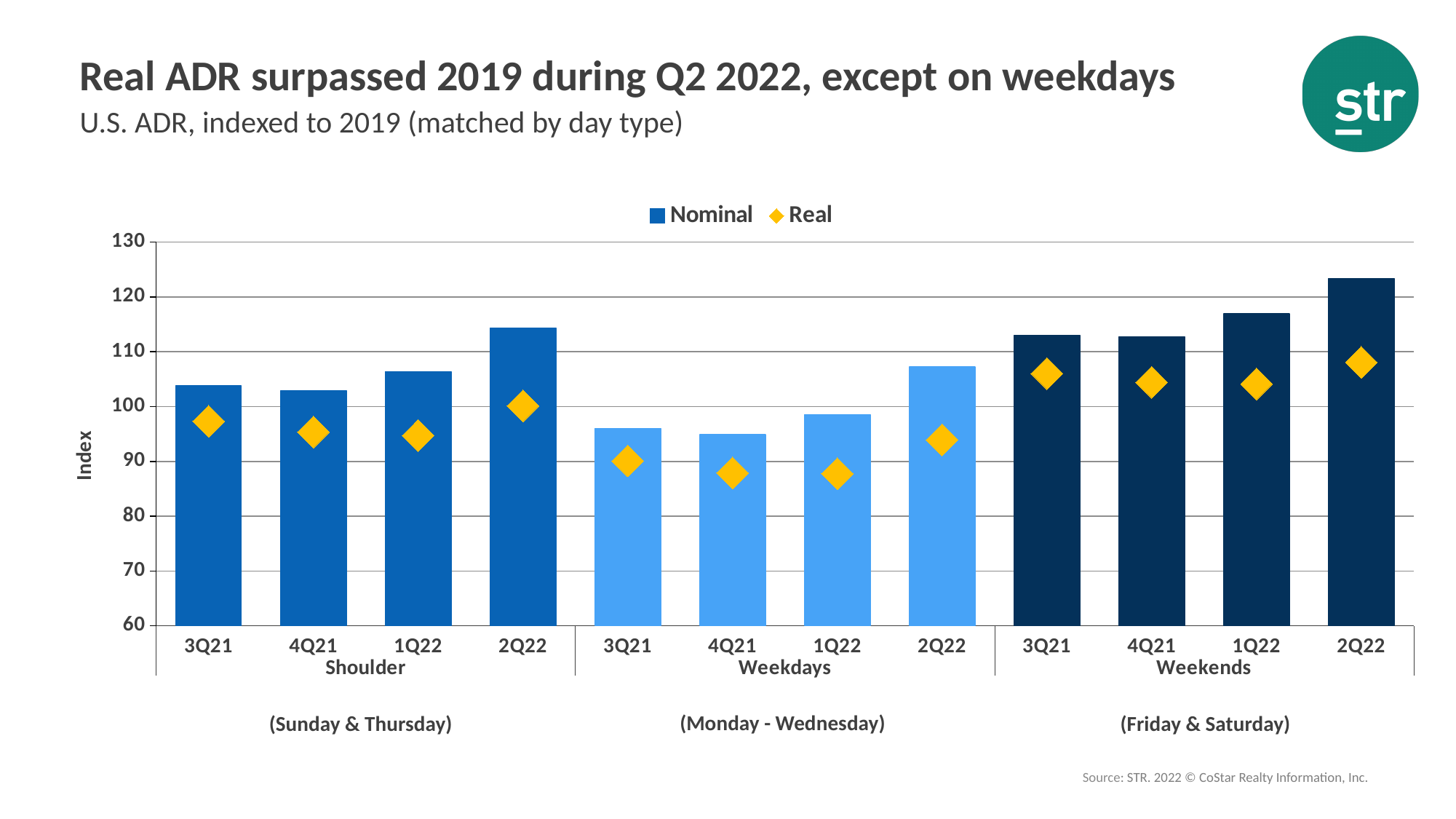
Within the Weekends group, does the Nominal index rise or fall from 1Q22 to 2Q22? rise What kind of chart is shown on the slide? bar chart Is the Nominal value for 3Q21 Weekdays greater or less than 100? less How many series does the legend list? 2 Which is larger, the Nominal value for 2Q22 Shoulder or the Nominal value for 2Q22 Weekdays? 2Q22 Shoulder What are the two entries in the chart legend? Nominal and Real Which bar has the highest Nominal index value? 2Q22 Weekends Is the Nominal value for 3Q21 Shoulder greater or less than 100? greater Is the Nominal value for 2Q22 Weekends greater or less than 120? greater How many bars are plotted in the chart? 12 Which point has the highest Real index value? 2Q22 Weekends